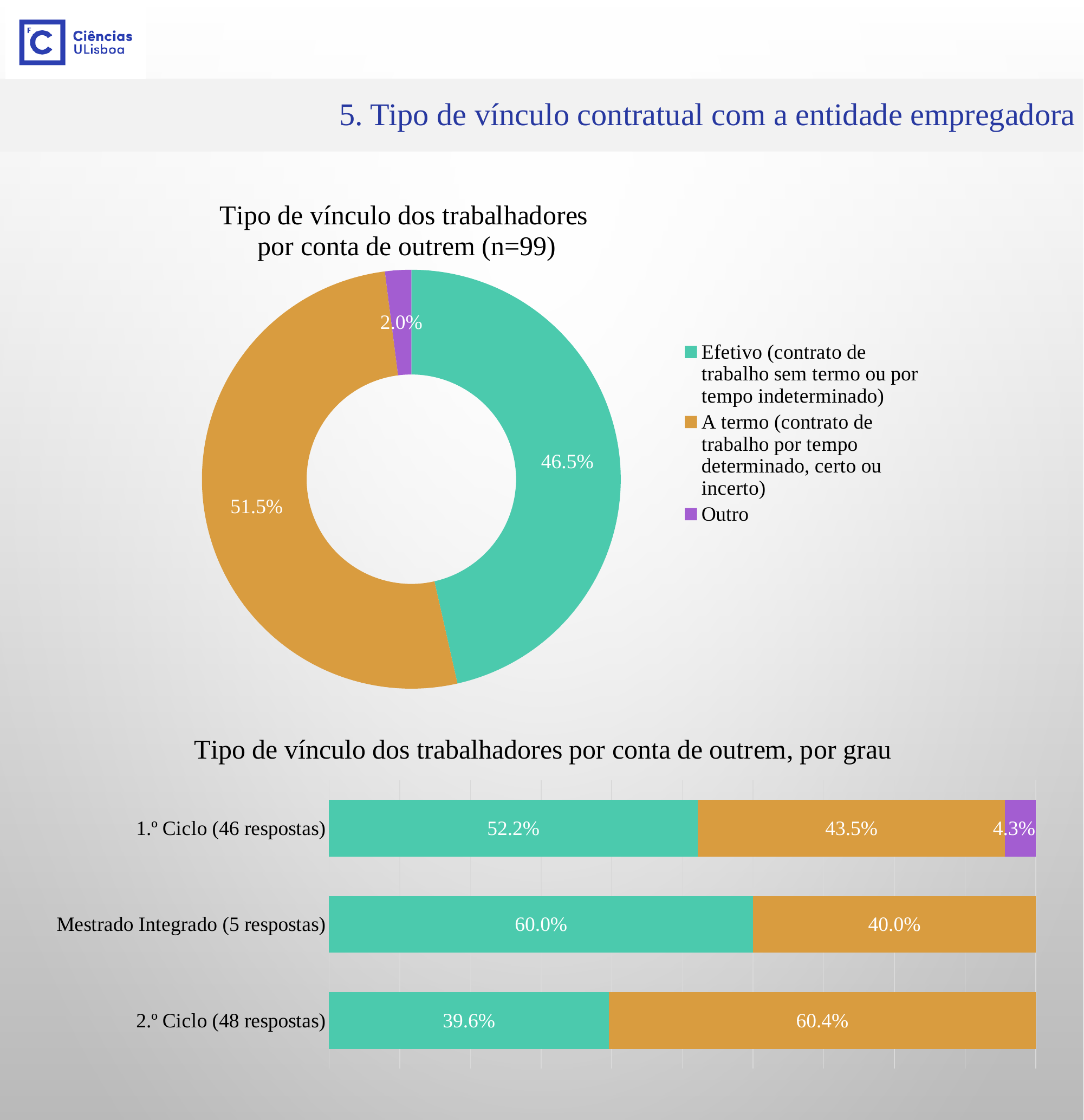
In the donut chart 'Tipo de vínculo dos trabalhadores por conta de outrem (n=99)', how many categories does the legend list? 3 What kind of chart is the top chart on the slide? Donut (pie) chart In the donut chart 'Tipo de vínculo dos trabalhadores por conta de outrem (n=99)', which category has the smallest share? Outro In the bar chart 'Tipo de vínculo dos trabalhadores por conta de outrem, por grau', what is the 'Efetivo' value for '1.º Ciclo (46 respostas)'? 52.2% In the bar chart 'Tipo de vínculo dos trabalhadores por conta de outrem, por grau', what is the 'Outro' value for '1.º Ciclo (46 respostas)'? 4.3% In the bar chart 'Tipo de vínculo dos trabalhadores por conta de outrem, por grau', what is the 'A termo' value for '2.º Ciclo (48 respostas)'? 60.4% In the donut chart 'Tipo de vínculo dos trabalhadores por conta de outrem (n=99)', what share is labelled for 'Outro'? 2.0% In the donut chart 'Tipo de vínculo dos trabalhadores por conta de outrem (n=99)', what share is labelled for 'A termo'? 51.5% In the bar chart 'Tipo de vínculo dos trabalhadores por conta de outrem, por grau', which degree has the highest 'Efetivo' share? Mestrado Integrado (5 respostas) In the donut chart 'Tipo de vínculo dos trabalhadores por conta de outrem (n=99)', what share is labelled for 'Efetivo'? 46.5% In the donut chart 'Tipo de vínculo dos trabalhadores por conta de outrem (n=99)', which category has the largest share? A termo In the bar chart 'Tipo de vínculo dos trabalhadores por conta de outrem, por grau', what is the difference between the 'A termo' and 'Efetivo' values for '2.º Ciclo (48 respostas)'? 20.8%